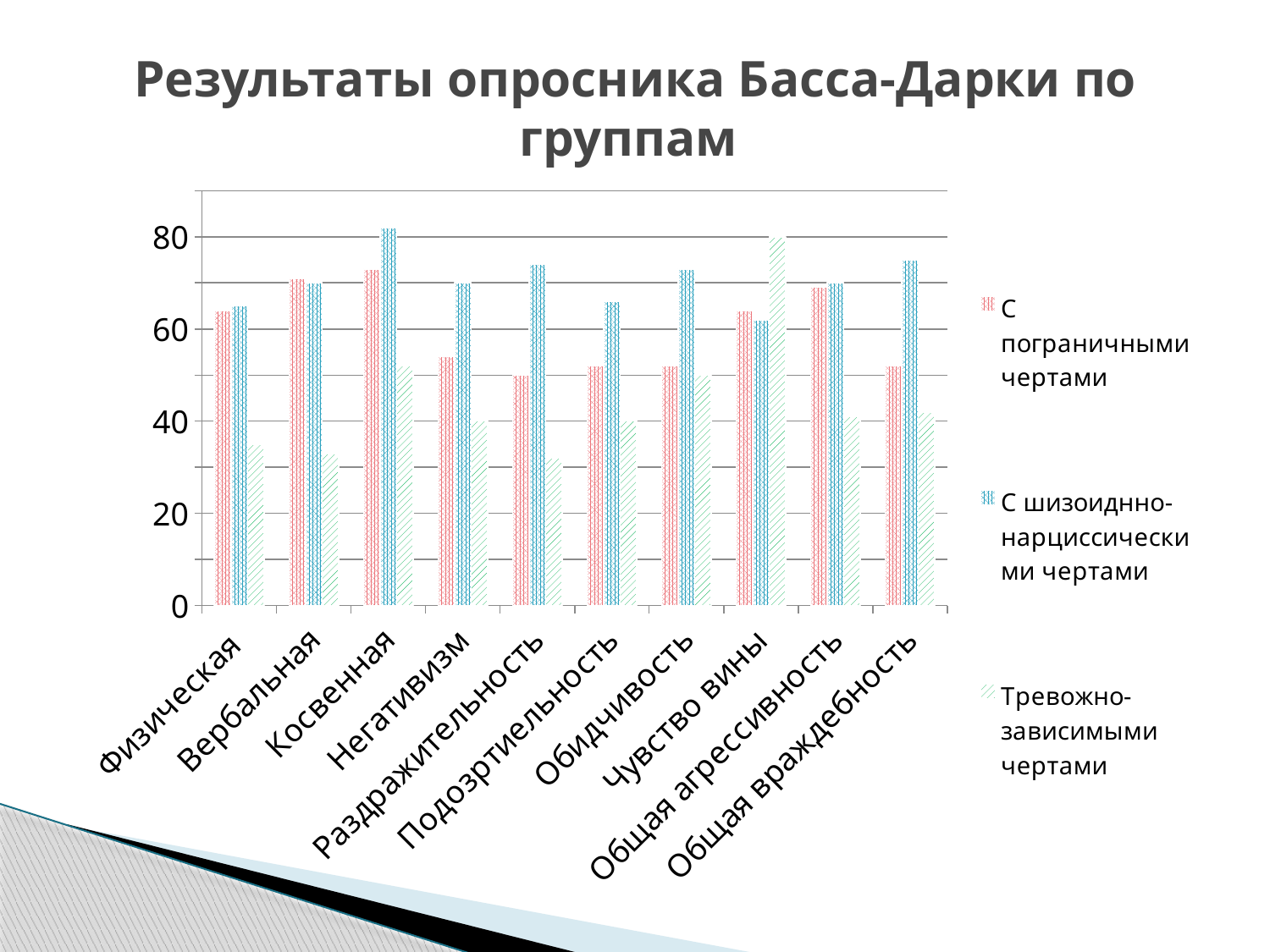
In the С шизоиднно-нарциссическими чертами series, which category has the highest value? Косвенная What kind of chart is shown on the slide? bar chart For Негативизм, which is larger: the value for С пограничными чертами or for С шизоиднно-нарциссическими чертами? С шизоиднно-нарциссическими чертами Is the value for Чувство вины in the Тревожно-зависимыми чертами series greater or less than 60? greater Is the value for Раздражительность in the С шизоиднно-нарциссическими чертами series greater or less than 60? greater How many categories are shown along the x axis of the chart? 10 In the Тревожно-зависимыми чертами series, which category has the highest value? Чувство вины Which series is listed last in the legend? Тревожно-зависимыми чертами What is the title of the chart on the slide? Результаты опросника Басса-Дарки по группам How many series does the legend list? 3 Is the value for Физическая in the Тревожно-зависимыми чертами series greater or less than 40? less